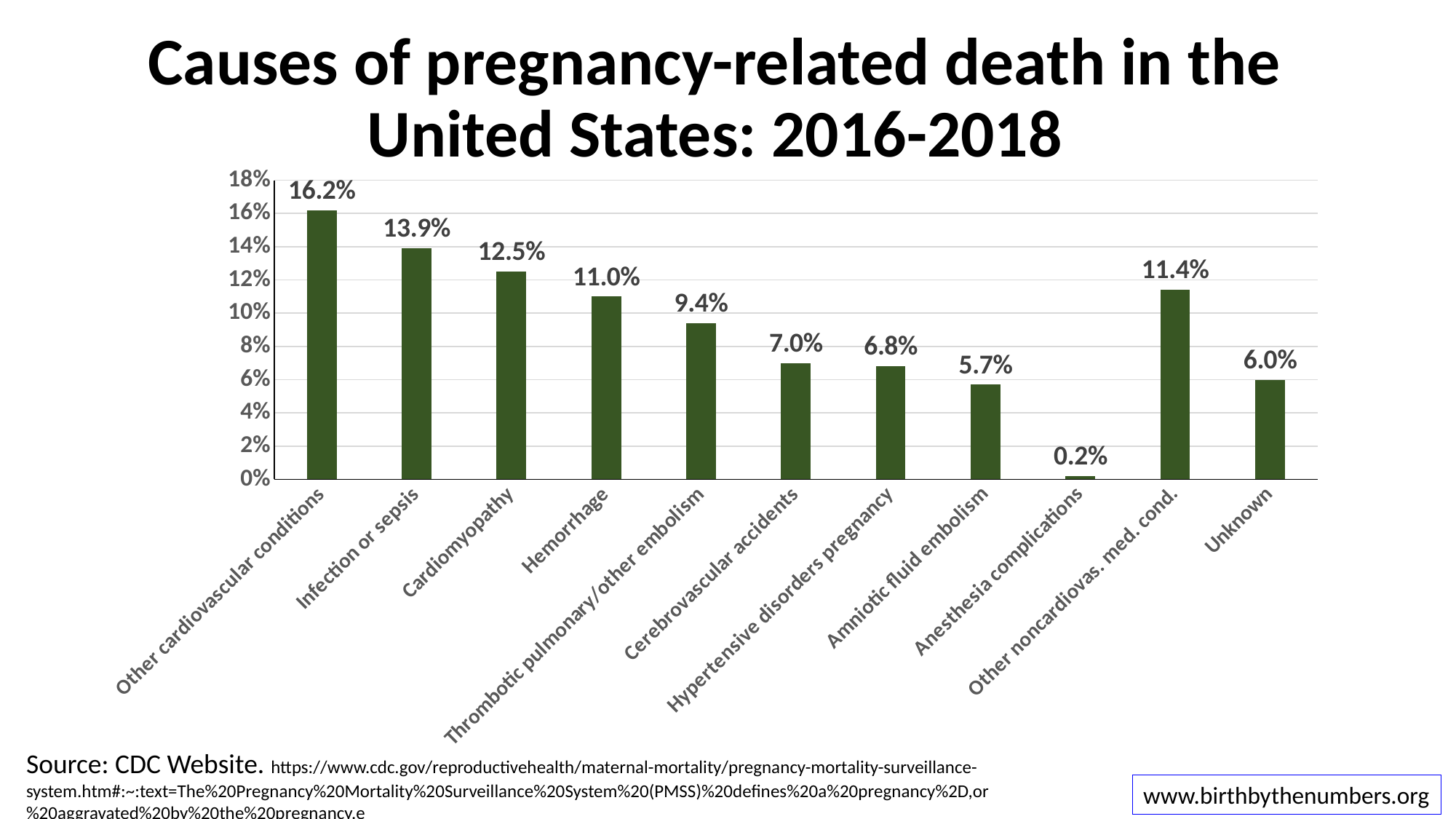
What is the difference between the values for Infection or sepsis and Cardiomyopathy? 1.4% What kind of chart is shown on the slide? bar chart What is the value for Cardiomyopathy? 12.5% Is the value for Thrombotic pulmonary/other embolism greater or less than 8%? greater Which category has the lowest value? Anesthesia complications What is the value for Other noncardiovas. med. cond.? 11.4% Which is larger, the value for Cerebrovascular accidents or the value for Unknown? Cerebrovascular accidents What is the title of the chart? Causes of pregnancy-related death in the United States: 2016-2018 How many categories are shown on the x axis? 11 What is the value for Amniotic fluid embolism? 5.7% Which category has the highest value? Other cardiovascular conditions What is the value for Hemorrhage? 11.0%